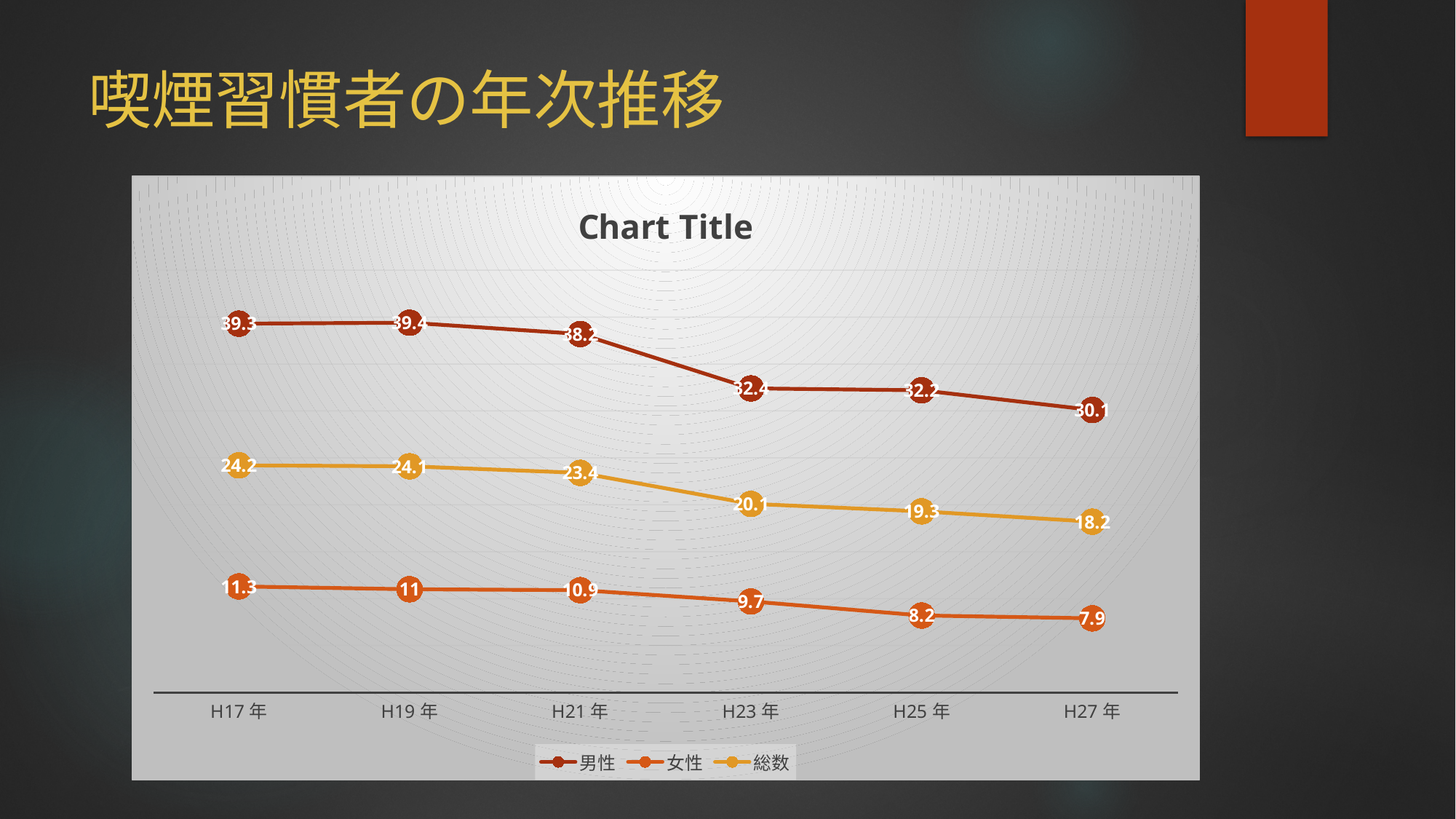
Which is larger at H25 年: the 総数 value or the 女性 value? 総数 How many years are shown on the x axis? 6 How many series does the legend list? 3 At which year is the 女性 series lowest? H27 年 What is the difference between the 男性 value at H17 年 and at H27 年? 9.2 What is the value for 総数 at H27 年? 18.2 What kind of chart is shown on the slide? Line chart At which year is the 男性 series highest? H19 年 What is the value for 男性 at H17 年? 39.3 What is the value for 女性 at H23 年? 9.7 What is the title shown on the chart? Chart Title Do the 総数 values rise or fall from H17 年 to H27 年? Fall